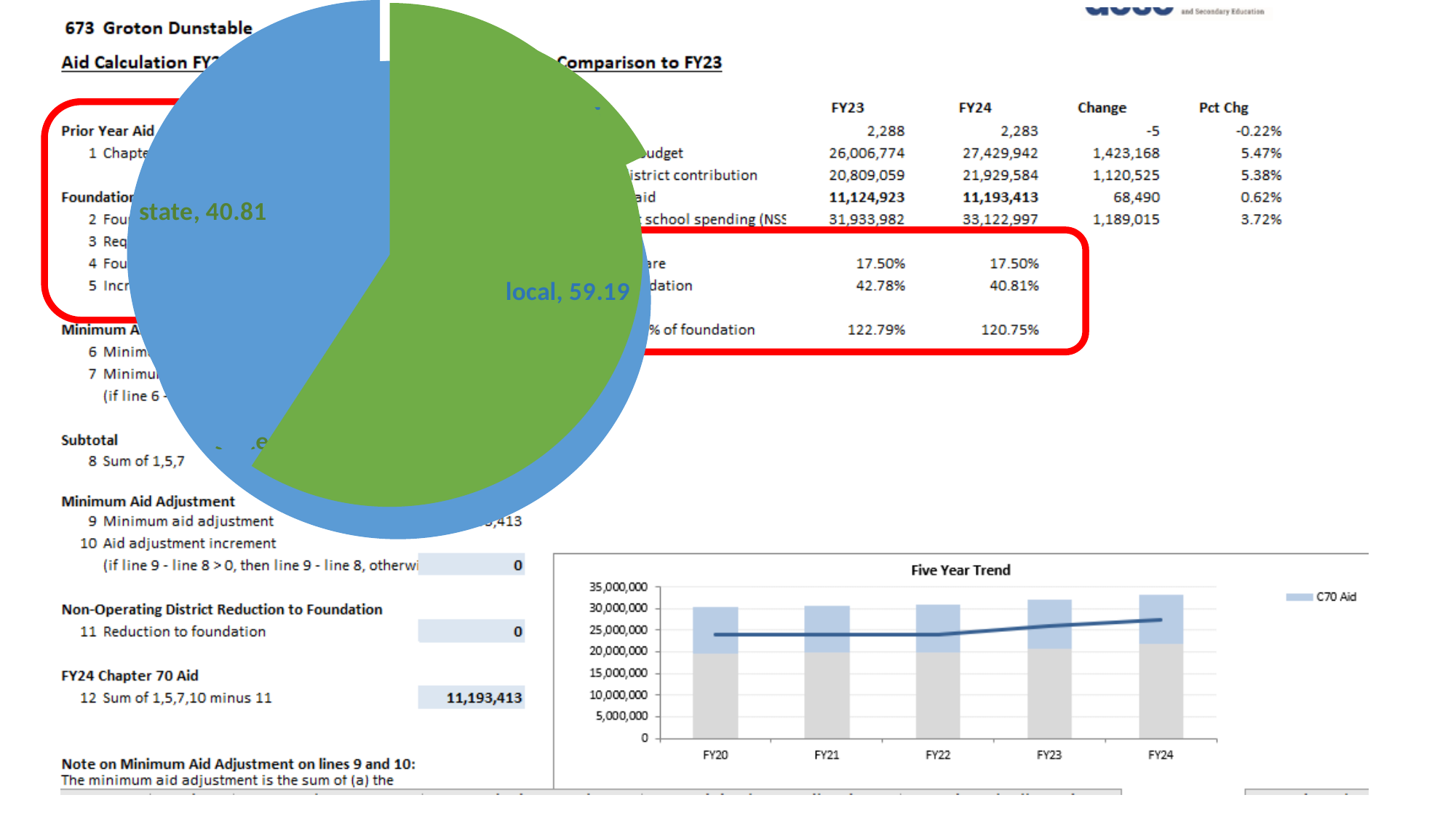
In the pie chart, what is the value for the state slice? 40.81 What kind of chart is the chart at the top left of the slide? pie chart In the Five Year Trend chart, does the line rise or fall from FY20 to FY24? rise How many slices does the pie chart have? 2 In the Five Year Trend chart, is the line value for FY24 greater or less than 25,000,000? greater What legend entry is shown for the Five Year Trend chart? C70 Aid In the pie chart, what is the value for the local slice? 59.19 In the pie chart, which slice is larger, state or local? local In the pie chart, what is the difference between the local and state values? 18.38 What is the title of the chart at the bottom right of the slide? Five Year Trend How many fiscal years are shown on the x axis of the Five Year Trend chart? 5 In the Five Year Trend chart, is the total height of the FY24 bar greater or less than 30,000,000? greater